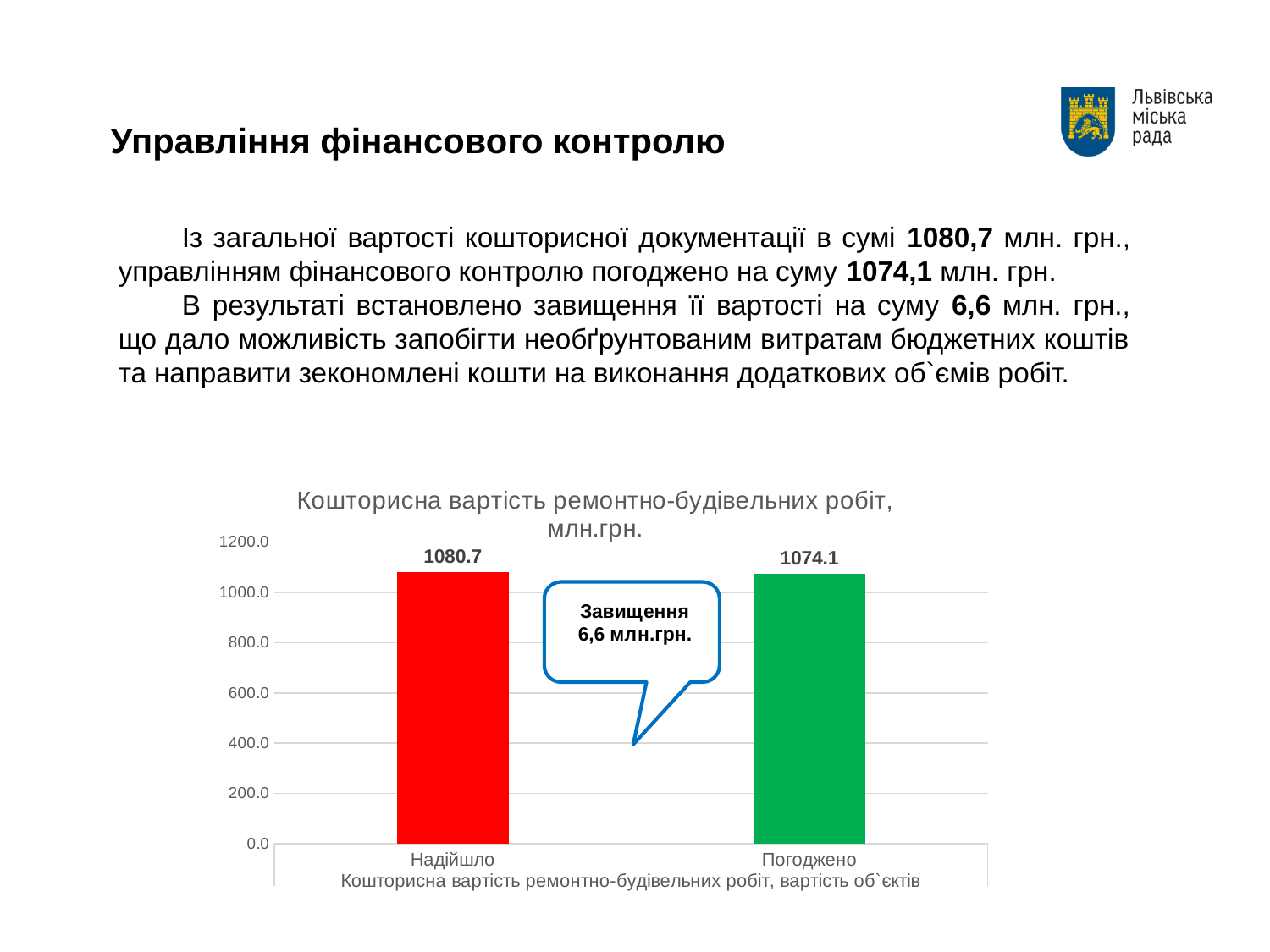
Is the value for Надійшло greater or less than 1200.0? less What amount does the callout between the bars state as the overstatement (Завищення)? 6,6 млн.грн. What is the total of the two bar values? 2154.8 What is the value for Надійшло? 1080.7 Is the value for Погоджено greater or less than 1000.0? greater Which category has the higher value, Надійшло or Погоджено? Надійшло What is the title of the chart? Кошторисна вартість ремонтно-будівельних робіт, млн.грн. How many bars are plotted in the chart? 2 What is the difference between the values for Надійшло and Погоджено? 6.6 What is the value for Погоджено? 1074.1 What kind of chart is shown on the slide? Bar chart